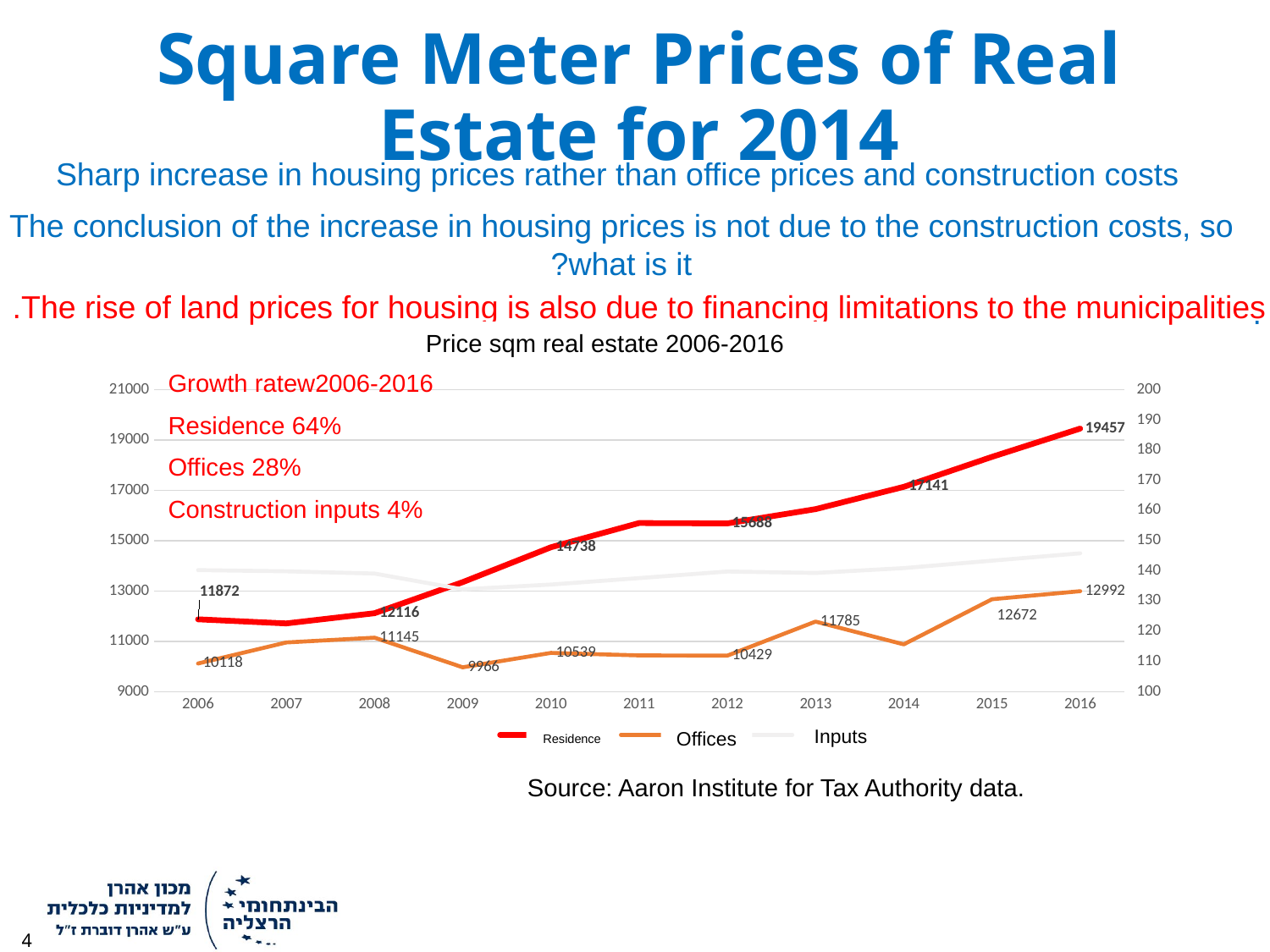
What is the difference between the Residence values for 2016 and 2006? 7585 Does the Residence series rise or fall from 2008 to 2016? rise What is the Residence value for 2012? 15688 What is the Offices value for 2015? 12672 In which year is the Offices series at its lowest labelled value? 2009 What is the Offices value for 2006? 10118 What is the Residence value for 2016? 19457 In which year is the Residence series at its highest labelled value? 2016 How many series does the chart legend list? 3 How many years are shown on the x axis? 11 Which is larger in 2010, the Residence value or the Offices value? Residence What type of chart is shown on the slide? line chart